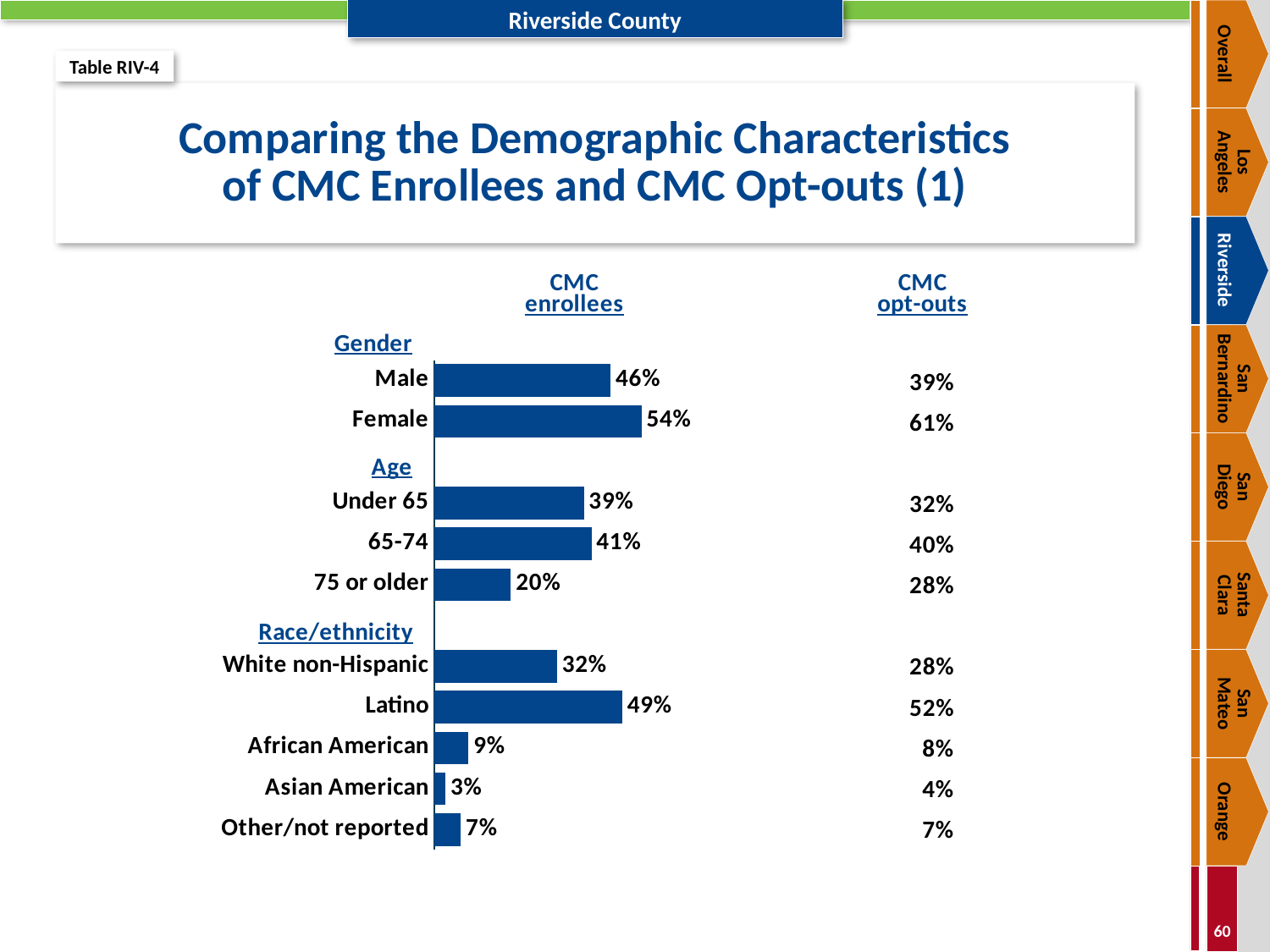
What is the CMC enrollees value for Female? 54% Which is larger for Under 65: the CMC enrollees value or the CMC opt-outs value? CMC enrollees How many race/ethnicity categories are shown in the chart? 5 What is the CMC opt-outs value for Latino? 52% Which race/ethnicity category has the highest CMC enrollees value? Latino Which race/ethnicity category has the lowest CMC enrollees value? Asian American What kind of chart is used to show the CMC enrollees values? Bar chart Which age group has the highest CMC opt-outs value? 65-74 What is the difference between the CMC enrollees values for Latino and White non-Hispanic? 17% What is the difference between the CMC enrollees and CMC opt-outs values for Male? 7% What is the title of the chart? Comparing the Demographic Characteristics of CMC Enrollees and CMC Opt-outs (1) What is the CMC enrollees value for 75 or older? 20%